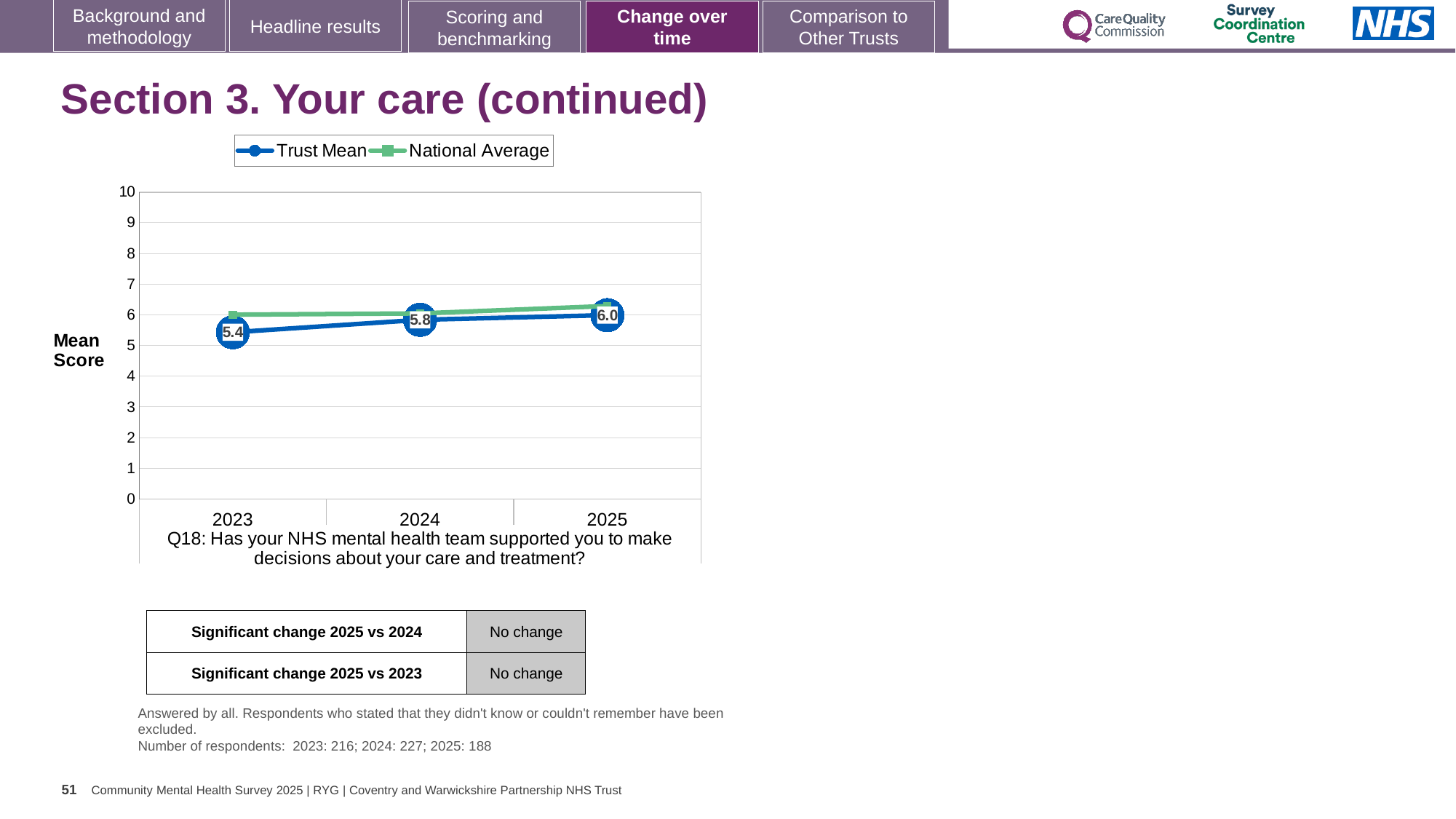
What kind of chart is shown? line chart What is the difference between the Trust Mean in 2025 and in 2023? 0.6 What is the Trust Mean score for 2024? 5.8 What is the Trust Mean score for 2023? 5.4 In which year is the Trust Mean lowest? 2023 Does the Trust Mean rise or fall from 2023 to 2025? rise Is the National Average for 2023 greater or less than 5? greater How many years are shown on the x axis? 3 What is the Trust Mean score for 2025? 6.0 In which year is the Trust Mean highest? 2025 Which is larger, the Trust Mean in 2024 or in 2023? 2024 How many series does the legend list? 2